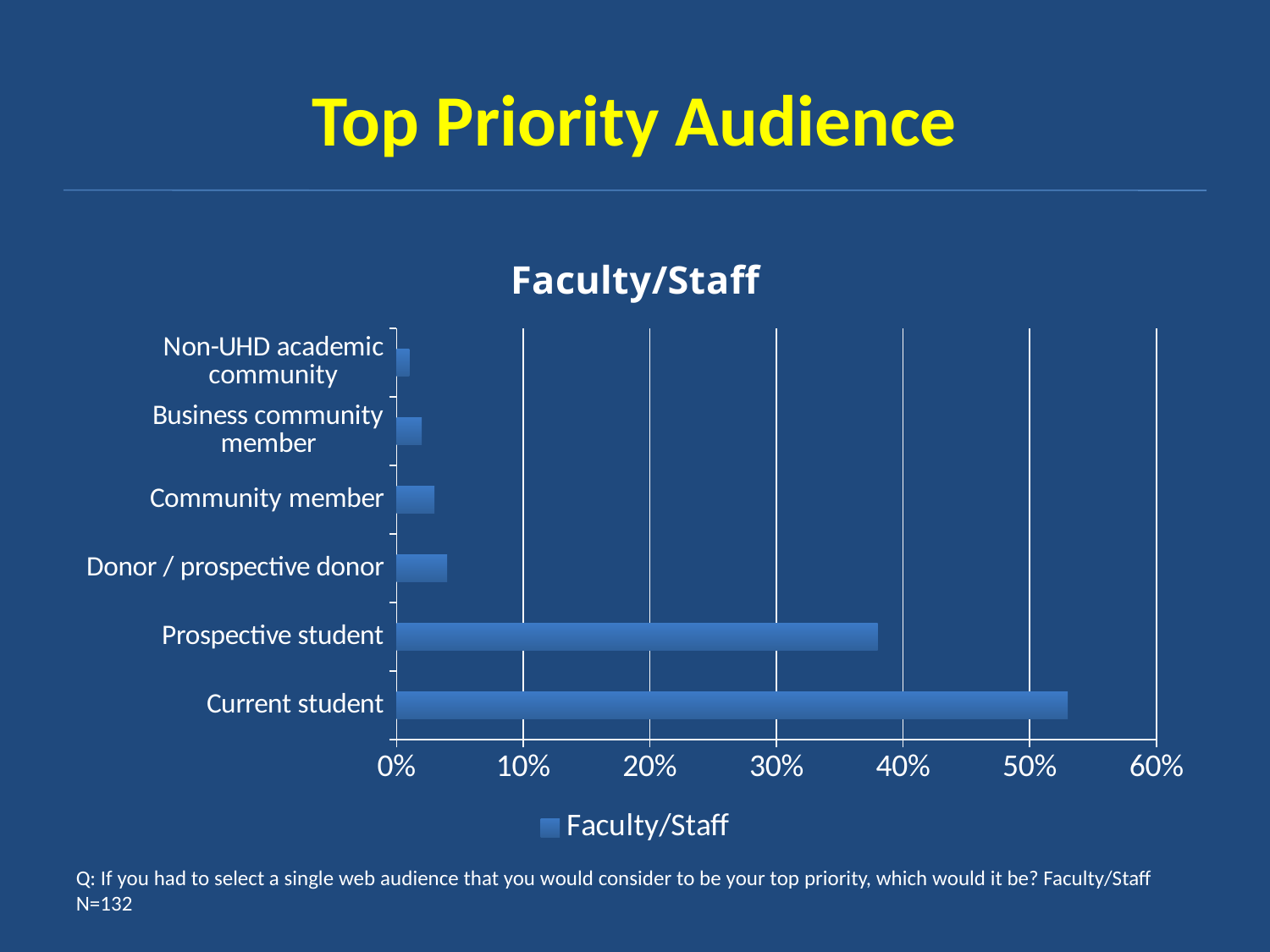
What is the name of the series listed in the legend? Faculty/Staff Is the value for Donor / prospective donor greater or less than 10%? less How many categories are shown on the chart? 6 What kind of chart is shown on the slide? bar chart Which category has the highest value? Current student Which category has the lowest value? Non-UHD academic community How many series does the legend list? 1 What is the title of the chart? Faculty/Staff Which is larger, the value for Current student or the value for Prospective student? Current student Which is larger, the value for Donor / prospective donor or the value for Non-UHD academic community? Donor / prospective donor Is the value for Current student greater or less than 50%? greater Is the value for Prospective student greater or less than 40%? less